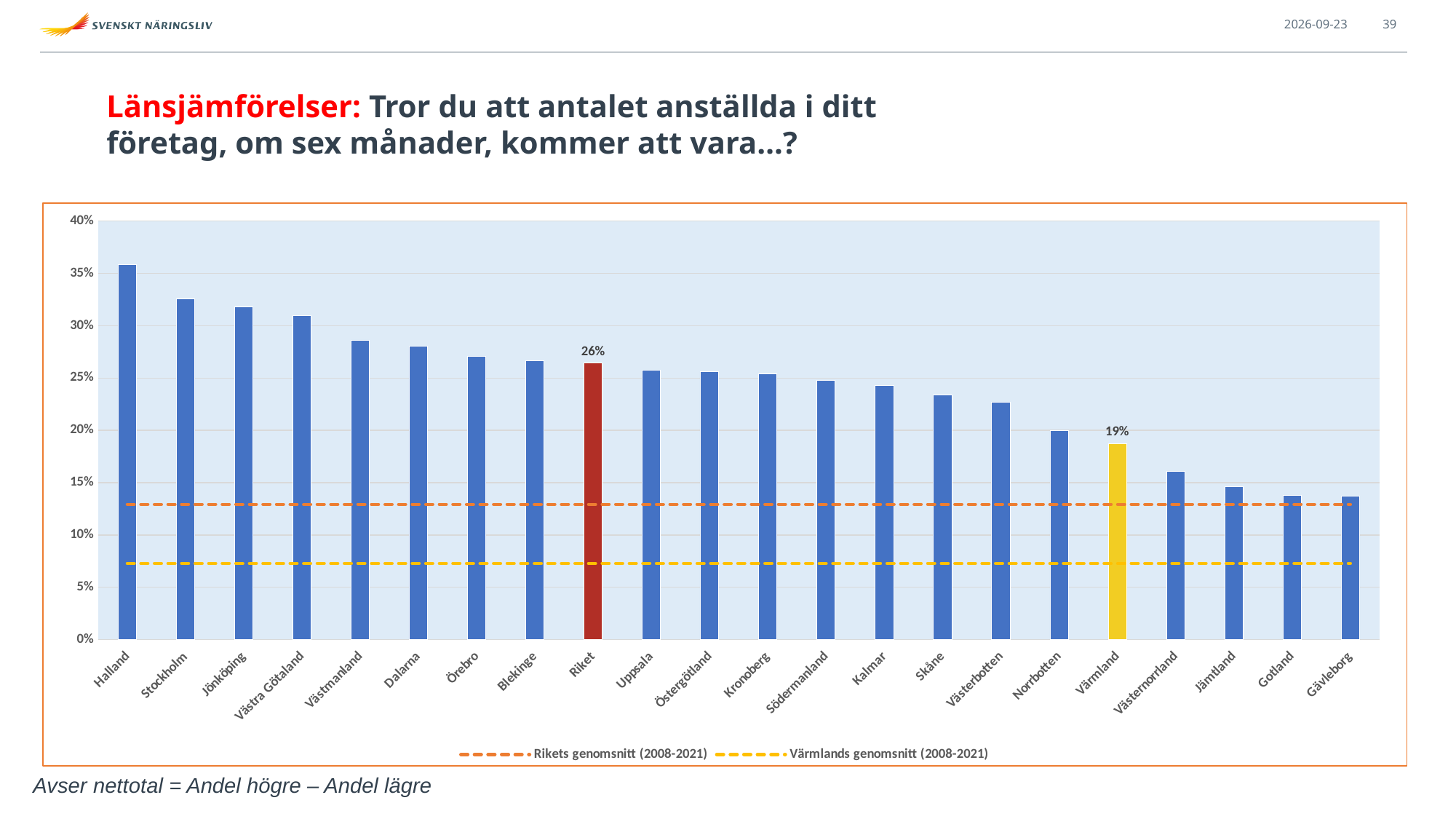
Do the bar values rise or fall from left to right along the x axis? Fall Which is larger, the value for Halland or the value for Stockholm? Halland Is the value for Kalmar greater or less than 25%? less What colour is the bar for Värmland? Yellow What is the value for Värmland? 19% Which county has the highest value? Halland Is the value for Stockholm greater or less than 30%? greater What is the difference between the values for Riket and Värmland? 7 percentage points What kind of chart is shown on the slide? Bar chart How many bars (categories) are plotted in the chart? 22 What is the value for Riket? 26% Which is larger, the value for Riket or the value for Värmland? Riket